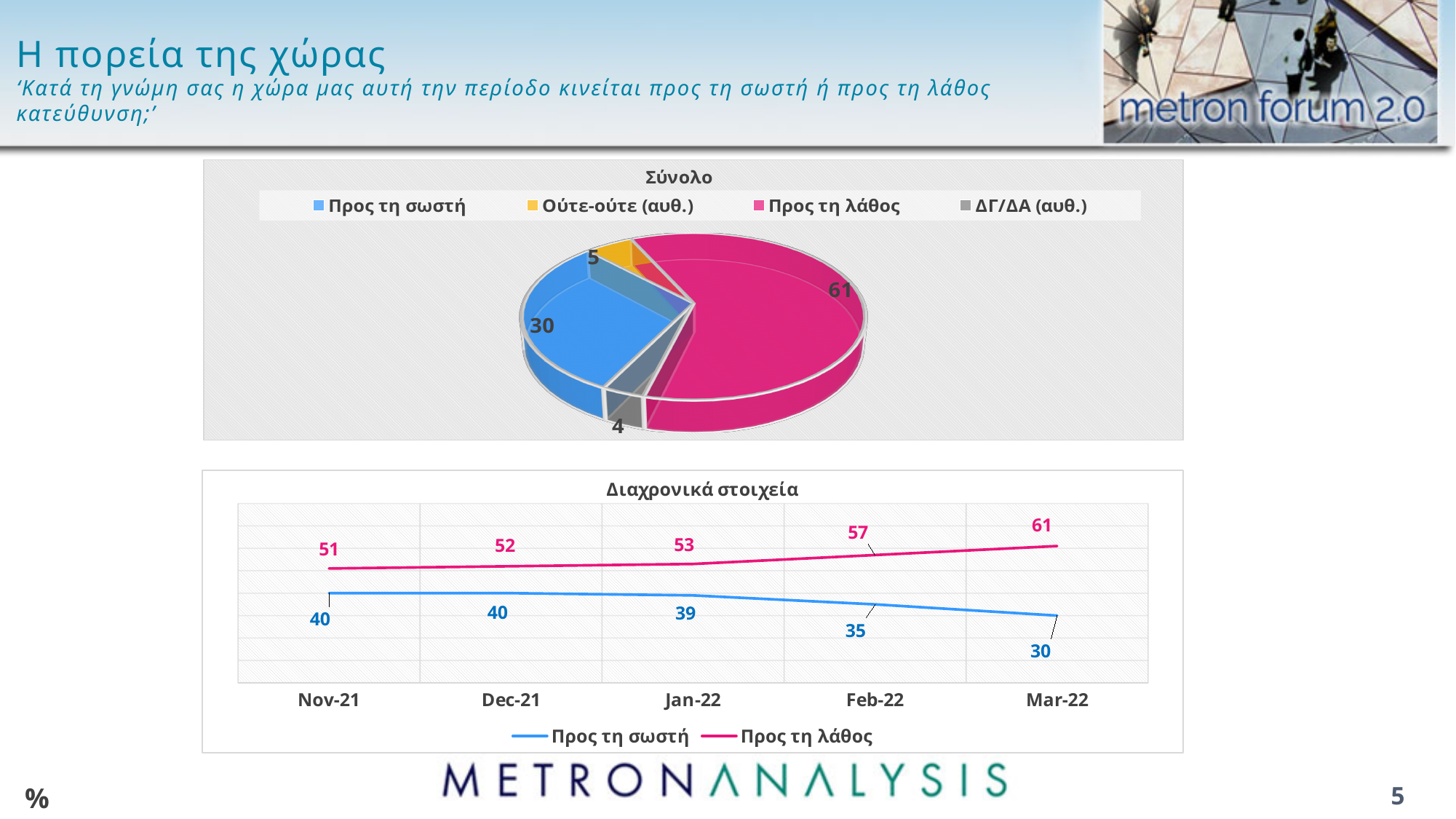
In the 'Σύνολο' pie chart, what is the difference between 'Προς τη λάθος' and 'Προς τη σωστή'? 31 In the 'Σύνολο' pie chart, which category has the largest slice? Προς τη λάθος In the 'Σύνολο' pie chart, how many categories does the legend list? 4 What kind of chart is 'Διαχρονικά στοιχεία'? line chart In the 'Διαχρονικά στοιχεία' chart, does the 'Προς τη σωστή' series rise or fall from Nov-21 to Mar-22? fall In the 'Διαχρονικά στοιχεία' chart, what is the value for 'Προς τη σωστή' in Jan-22? 39 In the 'Διαχρονικά στοιχεία' chart, what is the value for 'Προς τη λάθος' in Feb-22? 57 In the 'Σύνολο' pie chart, what is the value for 'Προς τη λάθος'? 61 In the 'Διαχρονικά στοιχεία' chart, how many time points are shown on the x axis? 5 In the 'Σύνολο' pie chart, what is the value for 'Προς τη σωστή'? 30 In the 'Διαχρονικά στοιχεία' chart, how many series does the legend list? 2 In the 'Σύνολο' pie chart, which category has the smallest slice? ΔΓ/ΔΑ (αυθ.)